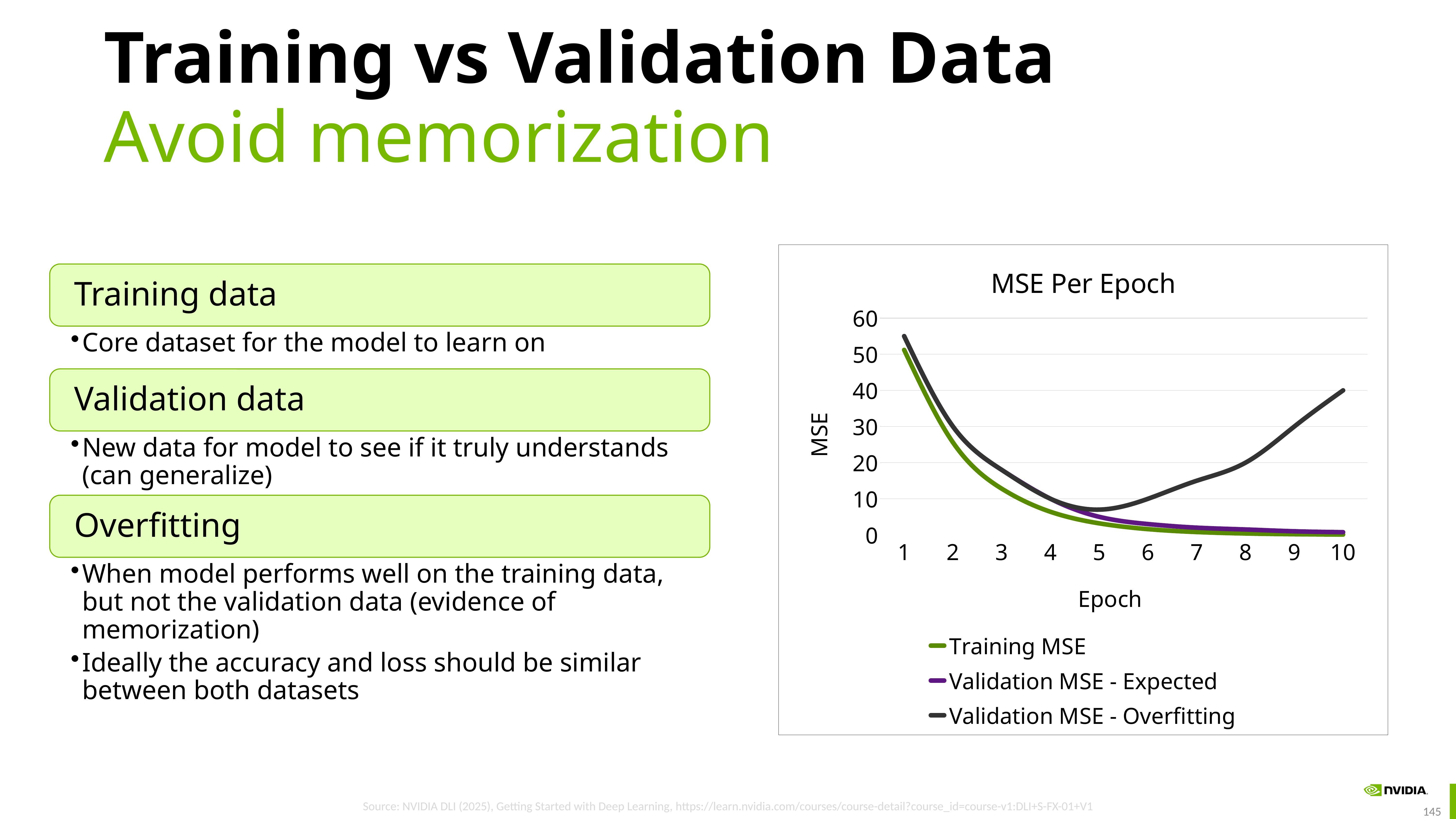
Is the Training MSE at epoch 10 greater or less than 10? less At which epoch is the Validation MSE - Overfitting line at its lowest? 5 Does the Validation MSE - Overfitting line rise or fall between epoch 5 and epoch 10? rise Does the Training MSE rise or fall as the epoch increases from 1 to 10? fall Is the Validation MSE - Overfitting value at epoch 10 greater or less than 30? greater At which epoch is the Training MSE at its highest? 1 Is the Training MSE at epoch 1 greater or less than 40? greater At epoch 10, which is larger: Validation MSE - Overfitting or Training MSE? Validation MSE - Overfitting How many series does the legend of the MSE Per Epoch chart list? 3 How many epochs are plotted along the x axis of the MSE Per Epoch chart? 10 What is the title of the chart on the slide? MSE Per Epoch What kind of chart is shown on the slide? line chart